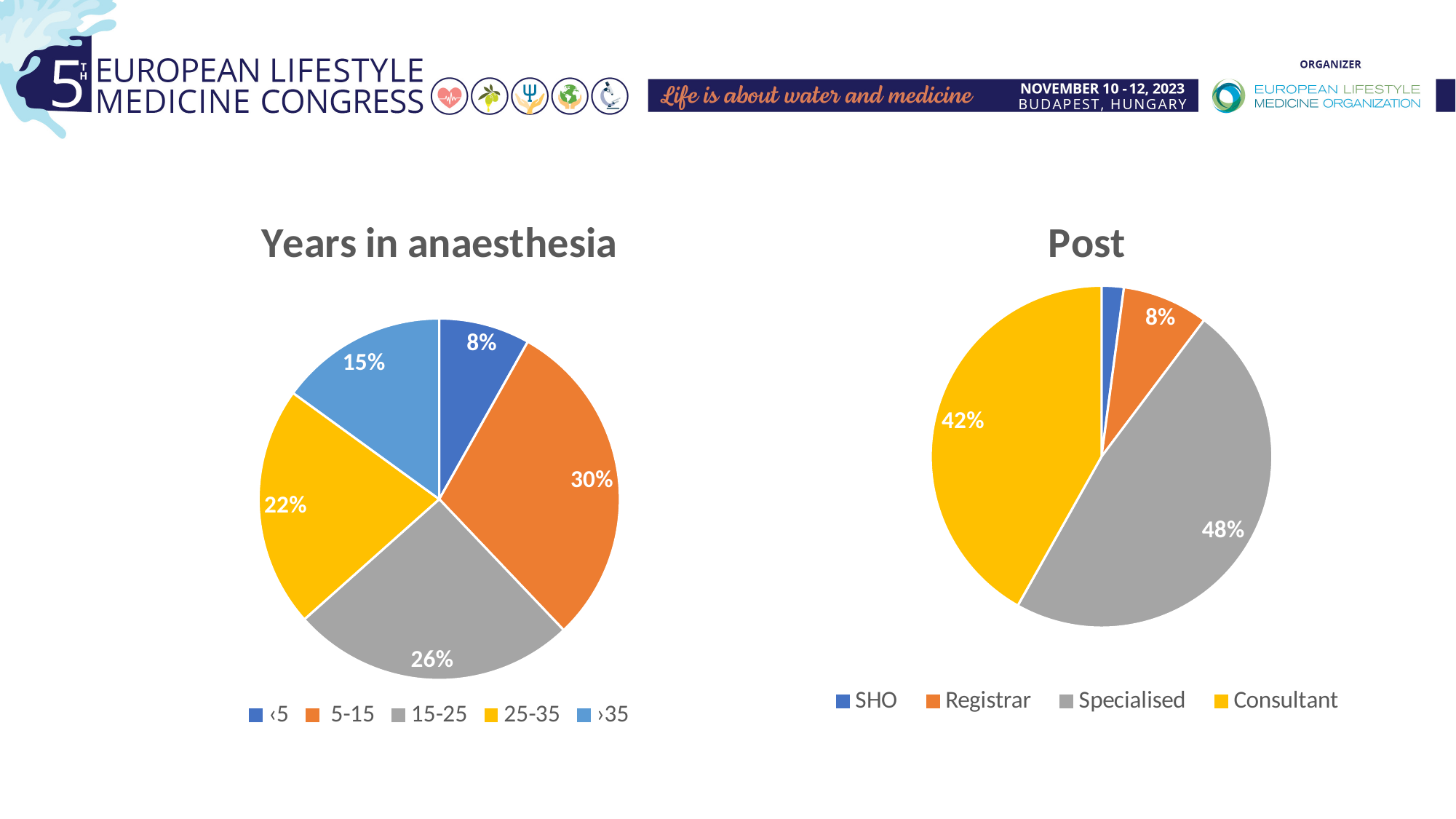
In the 'Years in anaesthesia' chart, what is the difference between the 15-25 share and the >35 share? 11% In the 'Post' chart, what percentage is shown for Specialised? 48% In the 'Years in anaesthesia' chart, which category has the largest share? 5-15 What type of chart is the 'Post' chart? Pie chart In the 'Years in anaesthesia' chart, what share of respondents have 5-15 years in anaesthesia? 30% In the 'Post' chart, what colour is the Consultant slice? Yellow In the 'Post' chart, what percentage is shown for Registrar? 8% In the 'Years in anaesthesia' chart, what percentage is shown for the 25-35 category? 22% In the 'Post' chart, which post has the largest share? Specialised In the 'Post' chart, which is larger, the Consultant share or the Registrar share? Consultant In the 'Years in anaesthesia' chart, which category has the smallest share? <5 In the 'Years in anaesthesia' chart, how many categories does the legend list? 5